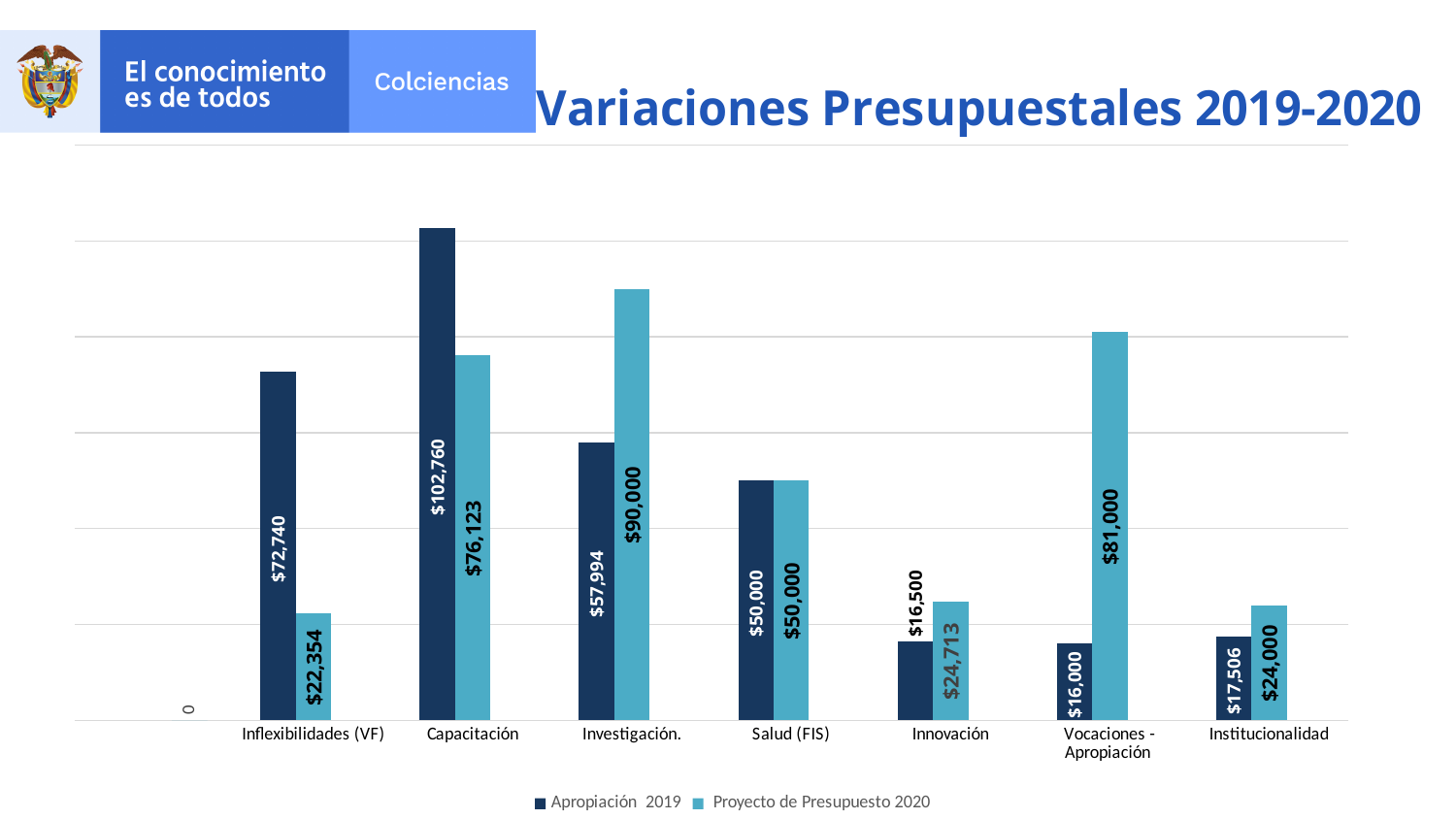
Which category has the highest Apropiación 2019 value? Capacitación What is the Apropiación 2019 value for Capacitación? $102,760 Which category has the highest Proyecto de Presupuesto 2020 value? Investigación. Which is larger for Innovación: the Apropiación 2019 value or the Proyecto de Presupuesto 2020 value? Proyecto de Presupuesto 2020 What kind of chart is shown on the slide? Bar chart How many categories are shown on the x axis? 7 What is the title of the chart? Variaciones Presupuestales 2019-2020 What is the Proyecto de Presupuesto 2020 value for Vocaciones - Apropiación? $81,000 What is the difference between the Proyecto de Presupuesto 2020 and Apropiación 2019 values for Investigación.? $32,006 Which category has the lowest Apropiación 2019 value? Vocaciones - Apropiación How many series does the legend list? 2 What is the Proyecto de Presupuesto 2020 value for Inflexibilidades (VF)? $22,354